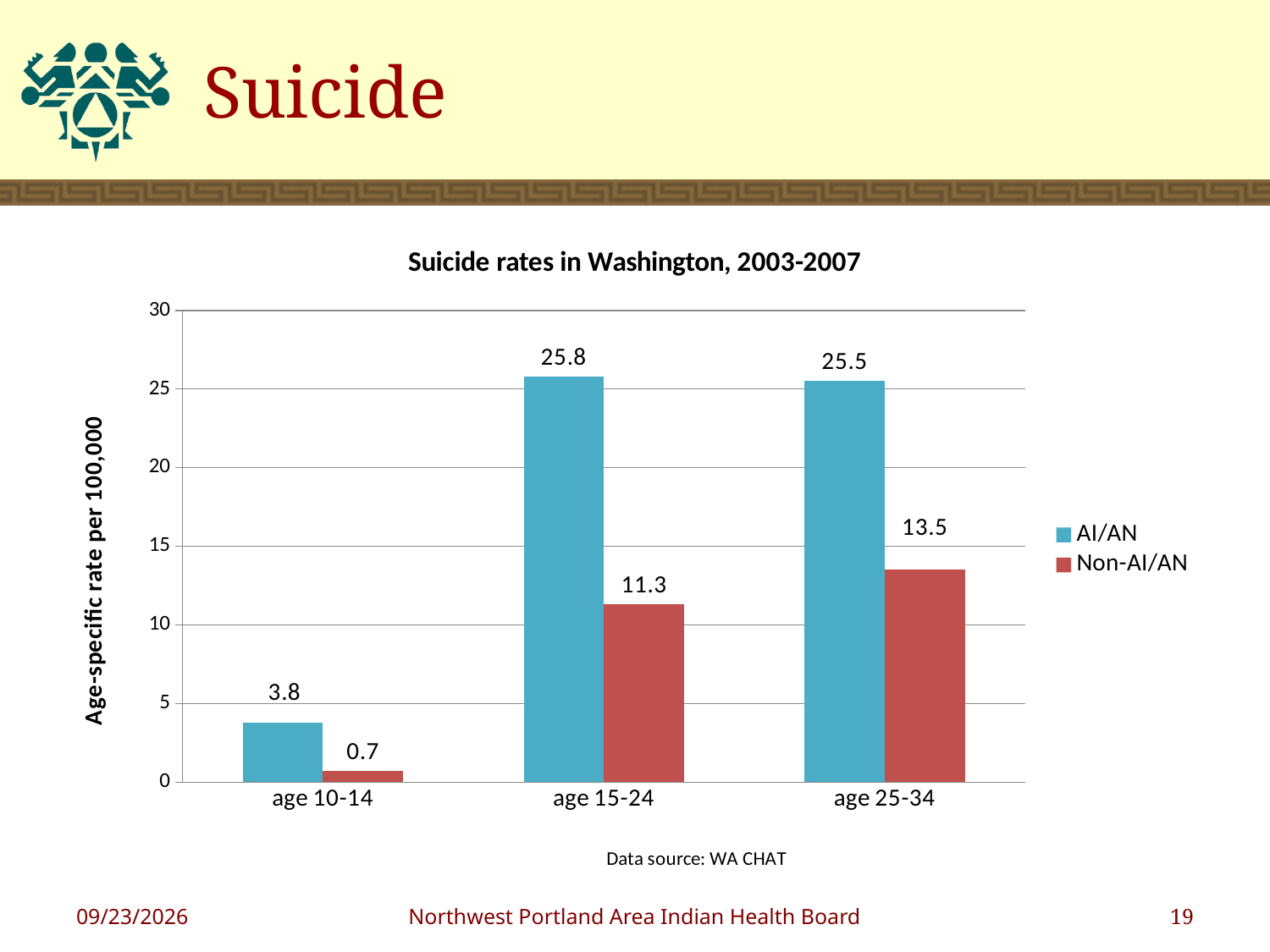
How many series does the legend list? 2 What is the AI/AN suicide rate for age 15-24? 25.8 Which age group has the lowest Non-AI/AN suicide rate? age 10-14 What is the Non-AI/AN suicide rate for age 25-34? 13.5 What is the difference between the AI/AN and Non-AI/AN suicide rates for age 25-34? 12 What kind of chart is shown on the slide? bar chart Which is larger for age 10-14, the AI/AN rate or the Non-AI/AN rate? AI/AN Which age group has the highest AI/AN suicide rate? age 15-24 What is the Non-AI/AN suicide rate for age 10-14? 0.7 Is the Non-AI/AN suicide rate for age 15-24 greater or less than 10? greater How many age groups are shown on the x axis? 3 What is the difference between the AI/AN and Non-AI/AN suicide rates for age 15-24? 14.5